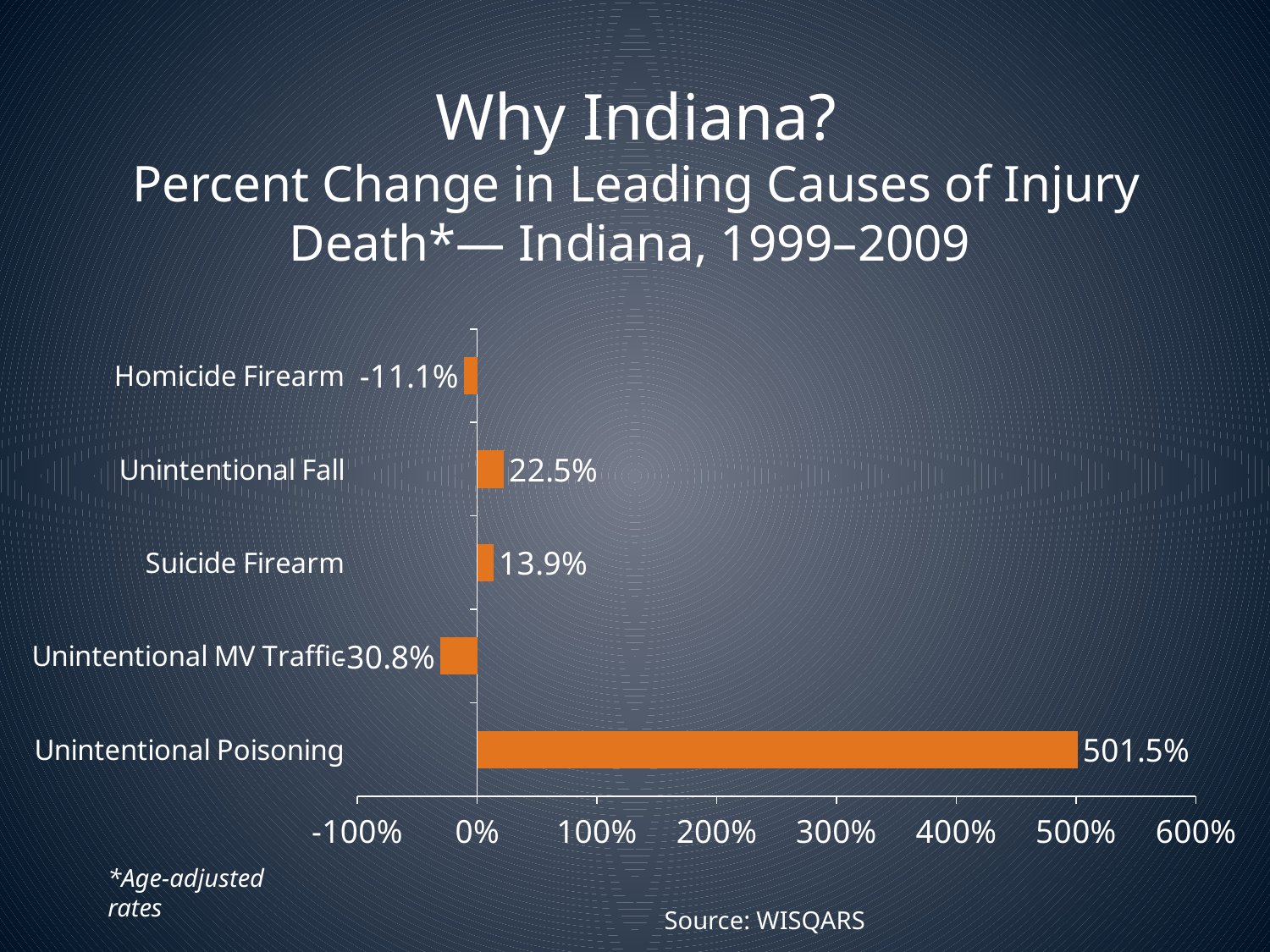
What is the percent change for Unintentional MV Traffic? -30.8% How many causes of injury death are shown in the chart? 5 What is the percent change for Unintentional Fall? 22.5% What type of chart is shown on the slide? Bar chart What is the percent change for Homicide Firearm? -11.1% Which cause of injury death has the lowest percent change? Unintentional MV Traffic What is the difference between the percent change for Unintentional Fall and Suicide Firearm? 8.6% What is the percent change for Suicide Firearm? 13.9% Which has a larger percent change, Unintentional Fall or Suicide Firearm? Unintentional Fall Which cause of injury death has the highest percent change? Unintentional Poisoning What is the source cited for the chart data? WISQARS What is the percent change for Unintentional Poisoning? 501.5%